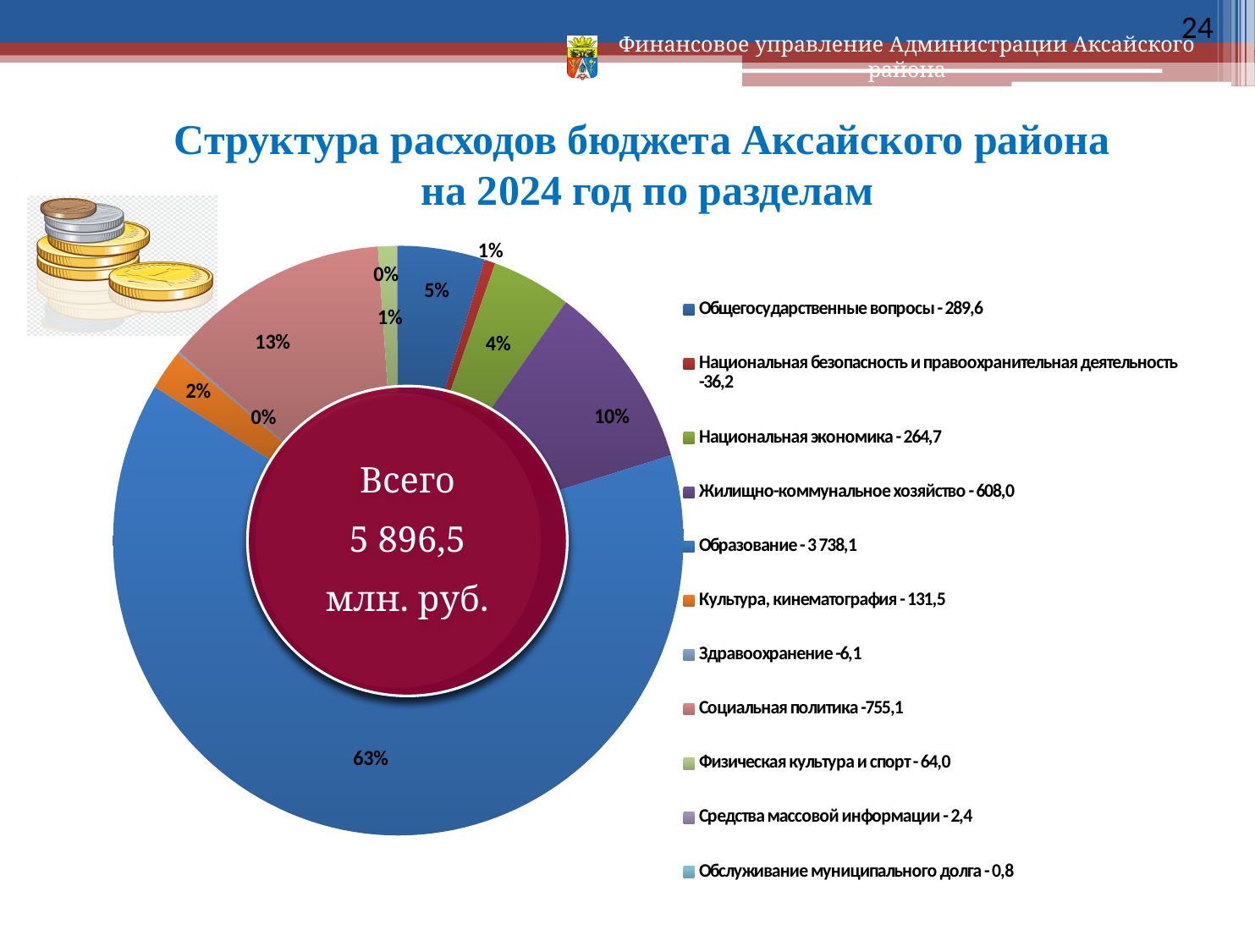
Which is larger: Общегосударственные вопросы or Национальная экономика? Общегосударственные вопросы What is the value for Жилищно-коммунальное хозяйство? 608,0 What kind of chart is shown on the slide? Doughnut chart What share of the pie does Социальная политика take? 13% What is the value for Образование in the legend? 3 738,1 Which section has the smallest value in the legend? Обслуживание муниципального долга What total is shown in the centre of the chart? 5 896,5 млн. руб. How many sections (categories) does the legend list? 11 What share of the pie does Образование take? 63% What is the value for Социальная политика? 755,1 Which section has the largest share of the budget expenditures? Образование What is the difference between the values for Образование and Жилищно-коммунальное хозяйство? 3 130,1